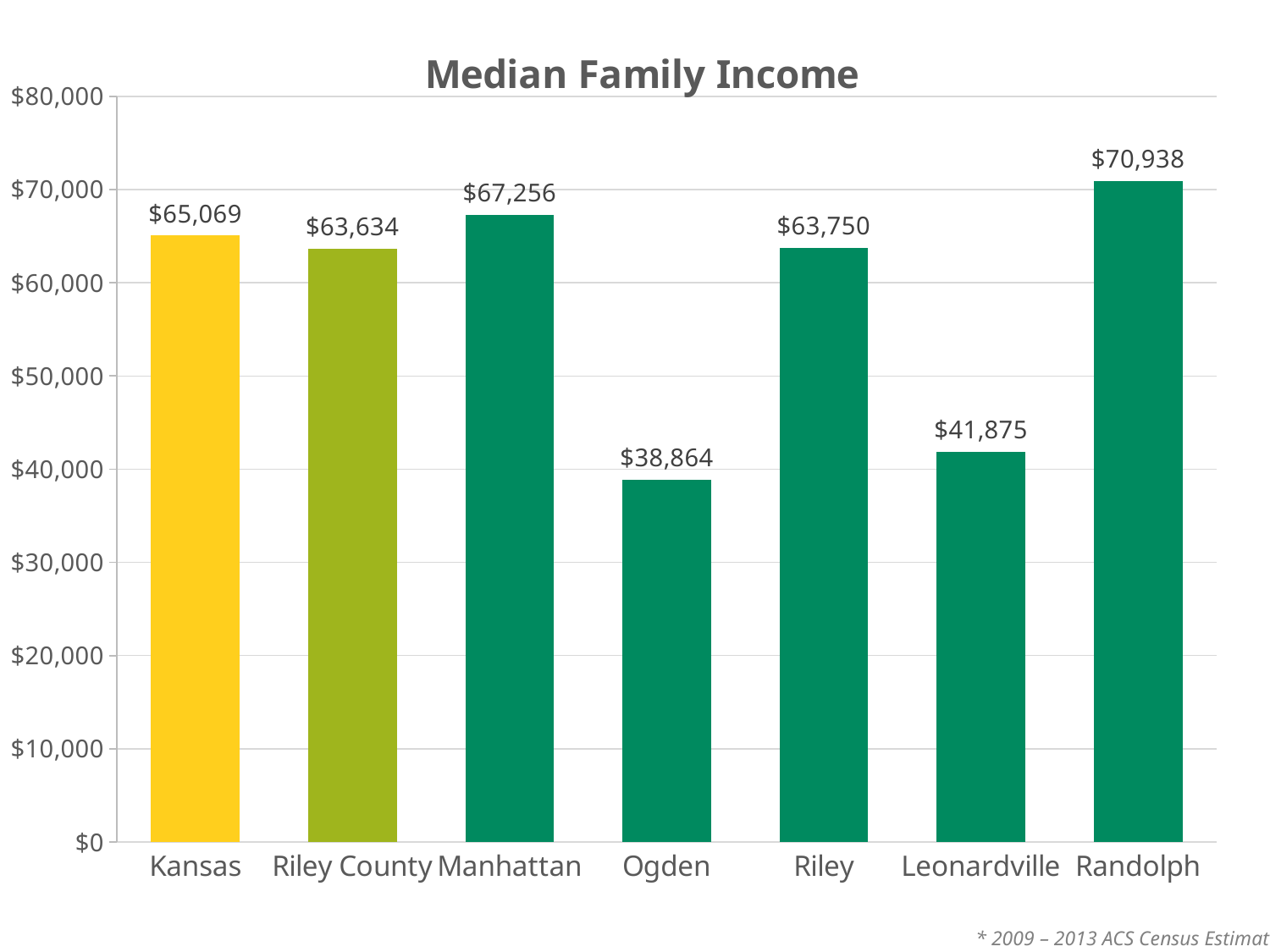
What is the difference between the median family income of Manhattan and Kansas? $2,187 What kind of chart is this? Bar chart What is the median family income for Ogden? $38,864 Which has a higher median family income, Leonardville or Riley? Riley What is the median family income for Kansas? $65,069 Is the median family income for Leonardville greater or less than $40,000? greater What is the title of the chart? Median Family Income Which category has the highest median family income? Randolph What is the difference between the median family income of Randolph and Ogden? $32,074 Which category has the lowest median family income? Ogden How many categories are shown on the chart? 7 What is the median family income for Manhattan? $67,256